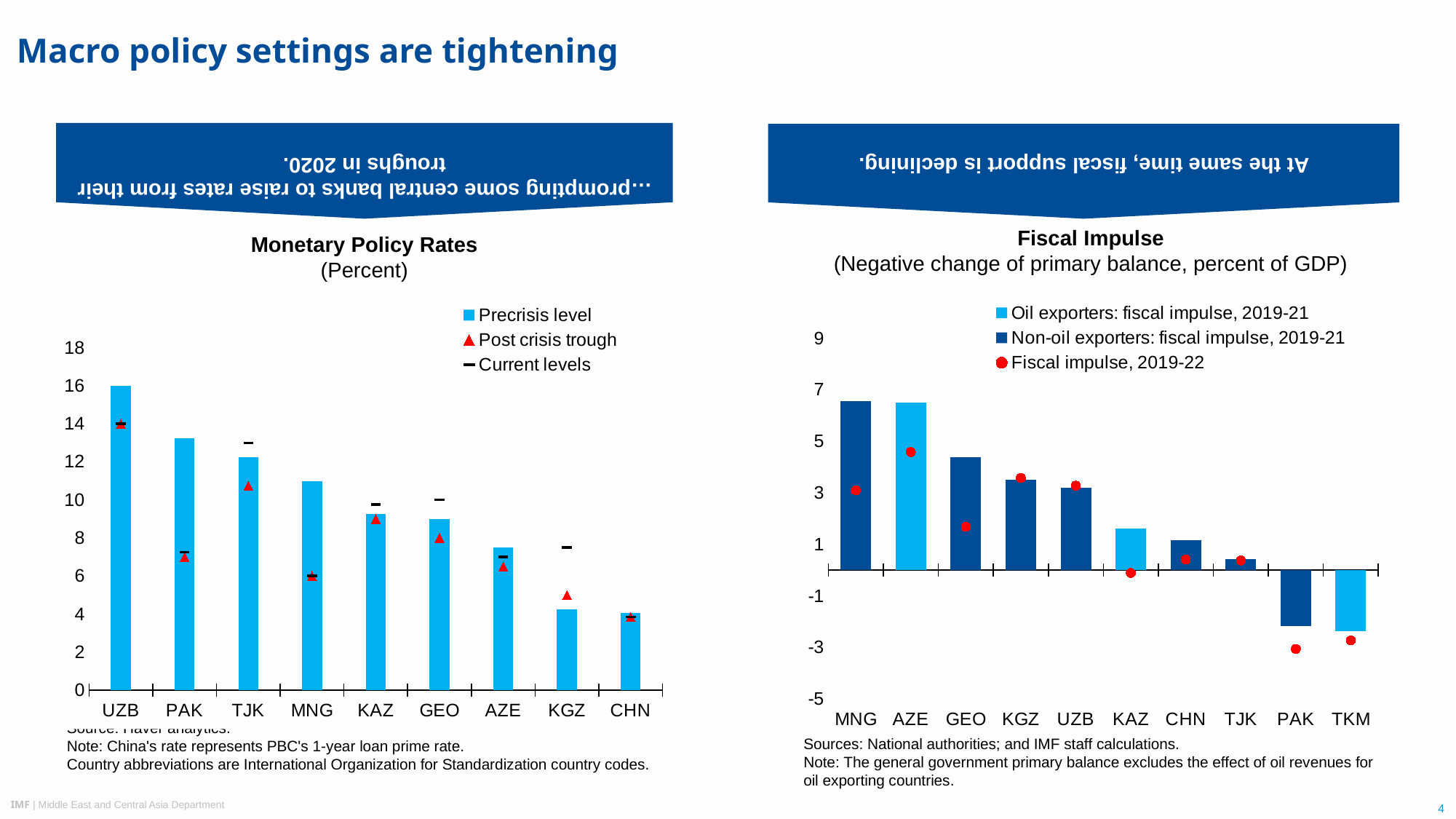
In the Fiscal Impulse chart, is the 2019-21 fiscal impulse bar for PAK greater or less than -1? less In the Monetary Policy Rates chart, do the precrisis level bars rise or fall from left to right? fall In the Fiscal Impulse chart, is the 2019-21 fiscal impulse bar for GEO greater or less than 3? greater In the Monetary Policy Rates chart, is the precrisis level for PAK greater or less than 12? greater How many countries are shown on the x axis of the Fiscal Impulse chart? 10 How many series does the legend of the Monetary Policy Rates chart list? 3 In the Fiscal Impulse chart, which colour are the bars for oil exporters? light blue In the Monetary Policy Rates chart, which country has the highest precrisis level? UZB How many countries are shown on the x axis of the Monetary Policy Rates chart? 9 What kind of chart is the Monetary Policy Rates chart? bar chart How many series does the legend of the Fiscal Impulse chart list? 3